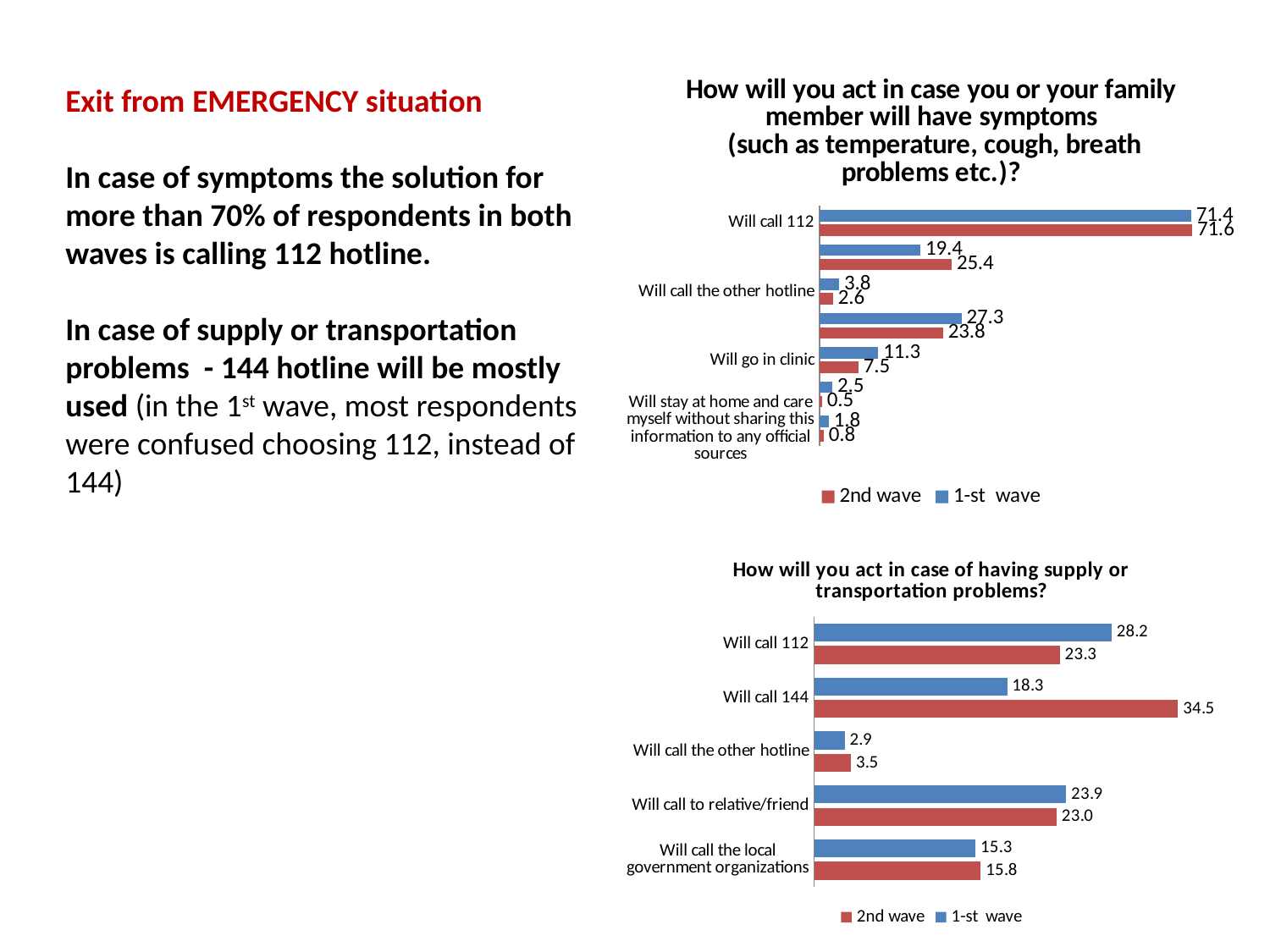
In the bottom chart (supply or transportation problems), what is the 1-st wave value for "Will call 112"? 28.2 In the bottom chart (supply or transportation problems), what is the difference between the 1-st wave and 2nd wave values for "Will call to relative/friend"? 0.9 In the top chart (symptoms question), what is the 1-st wave value for "Will go in clinic"? 11.3 In the bottom chart (supply or transportation problems), how much higher is the 2nd wave value than the 1-st wave value for "Will call 144"? 16.2 How many series does the legend of the bottom chart (supply or transportation problems) list? 2 In the bottom chart (supply or transportation problems), which category has the highest 2nd wave value? Will call 144 How many categories are shown in the bottom chart (supply or transportation problems)? 5 In the bottom chart (supply or transportation problems), what is the 2nd wave value for "Will call 144"? 34.5 In the top chart (symptoms question), what is the 2nd wave value for "Will call 112"? 71.6 What kind of chart is the top chart (symptoms question)? Bar chart In the bottom chart (supply or transportation problems), which category has the lowest 1-st wave value? Will call the other hotline In the top chart (symptoms question), which has the larger 1-st wave value: "Will go in clinic" or "Will call the other hotline"? Will go in clinic